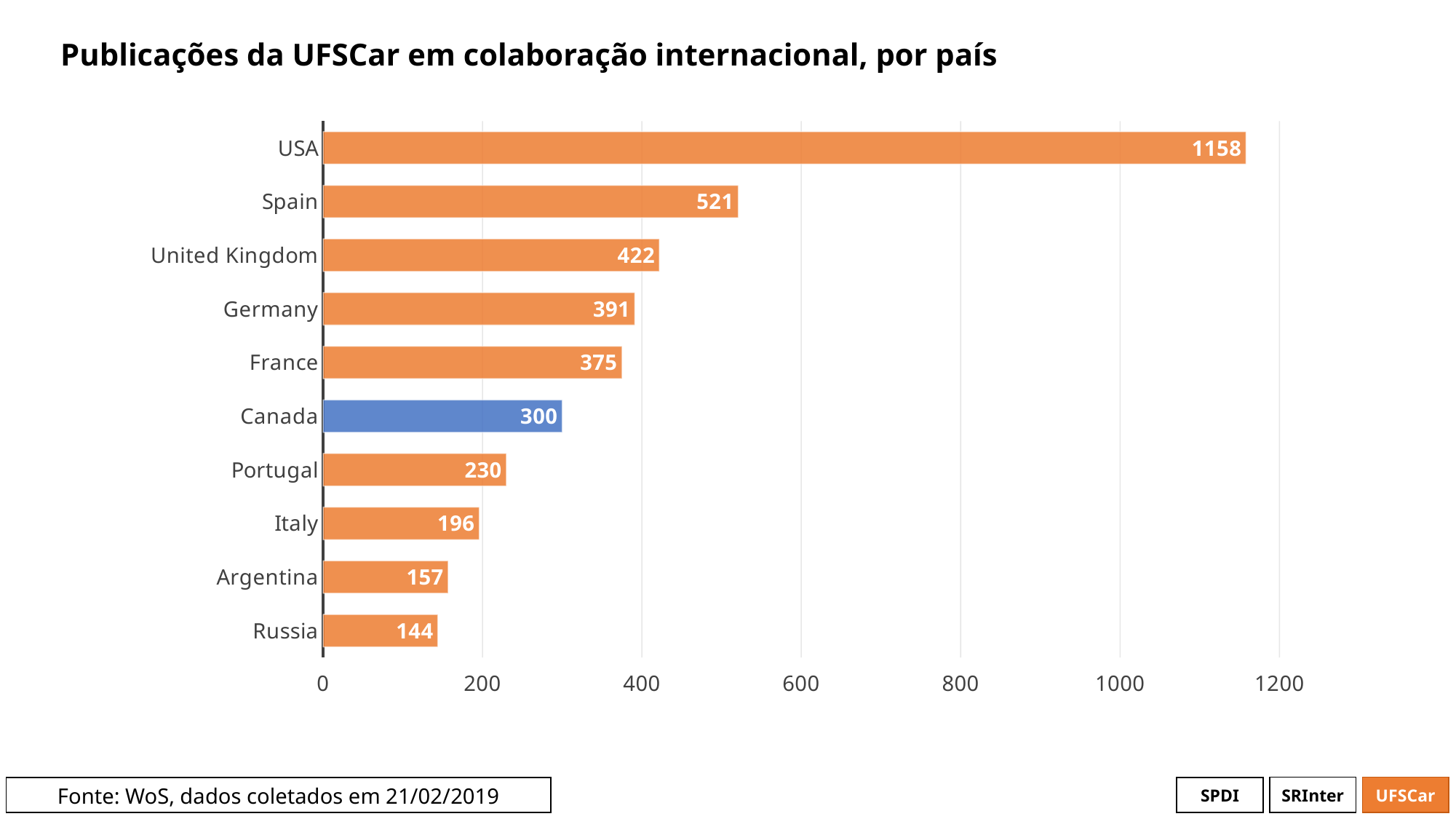
Which country has the lowest value? Russia Which country has the highest value? USA What is the value for USA? 1158 Is the value for Spain greater or less than 400? greater What is the value for Canada? 300 Which country's bar is coloured blue instead of orange? Canada Which is larger, the value for Germany or the value for France? Germany What is the value for Portugal? 230 What is the difference between the values for Spain and United Kingdom? 99 What kind of chart is shown on the slide? bar chart How many countries are shown in the chart? 10 What is the difference between the values for Italy and Argentina? 39